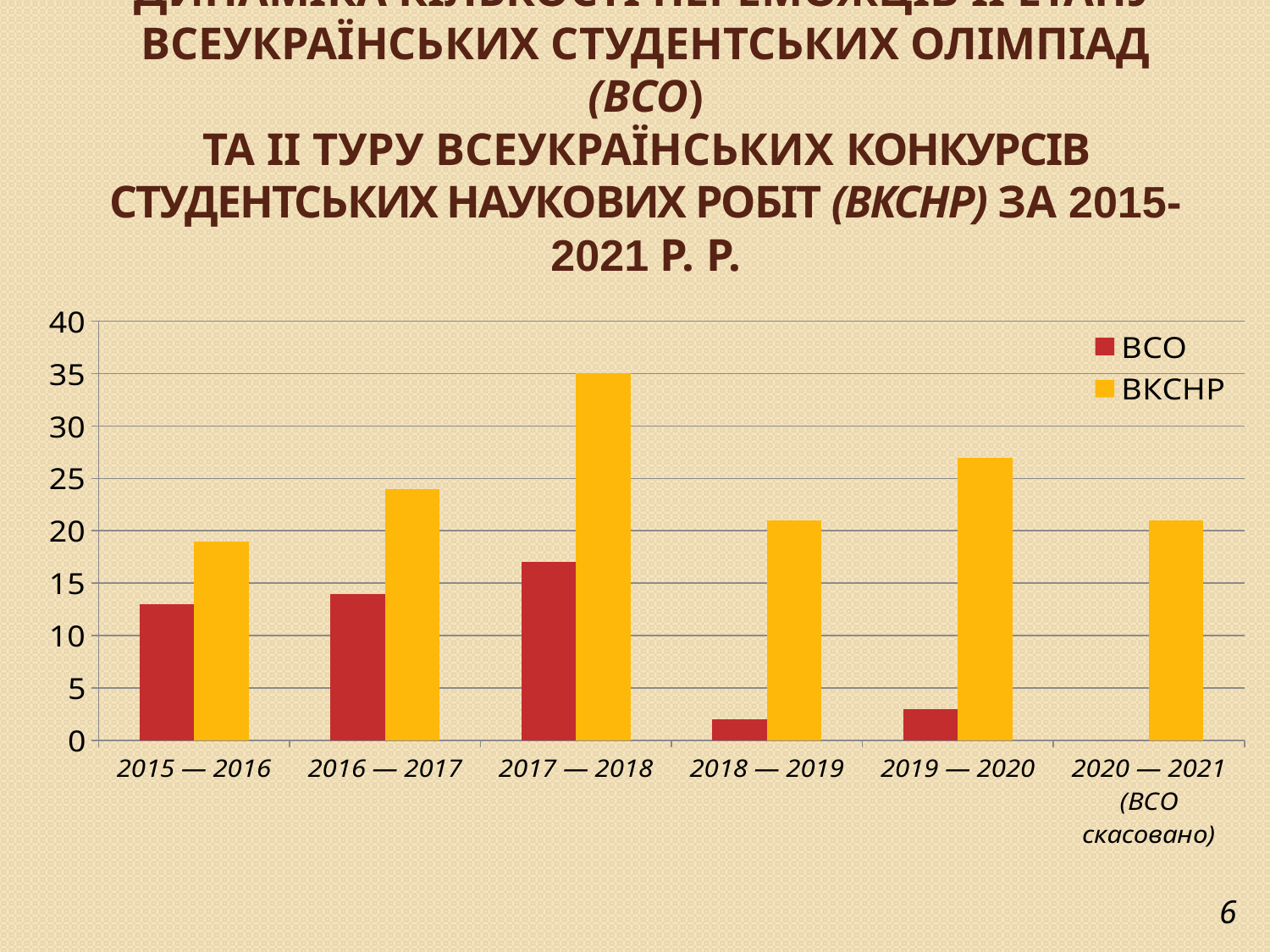
Which is larger: the ВКСНР value for 2019 — 2020 or the ВКСНР value for 2018 — 2019? 2019 — 2020 Is the ВСО value for 2015 — 2016 greater or less than 10? greater Which series is shown in red in the legend? ВСО How many series does the legend list? 2 Which academic year has the highest ВСО value? 2017 — 2018 Is the ВСО value for 2019 — 2020 greater or less than 5? less What kind of chart is shown on the slide? bar chart How many academic-year categories are shown on the x axis? 6 Which is larger for 2016 — 2017: the ВСО value or the ВКСНР value? ВКСНР Which academic year has the highest ВКСНР value? 2017 — 2018 Which academic year has the lowest ВСО bar among those with a ВСО bar? 2018 — 2019 Is the ВКСНР value for 2017 — 2018 greater or less than 30? greater